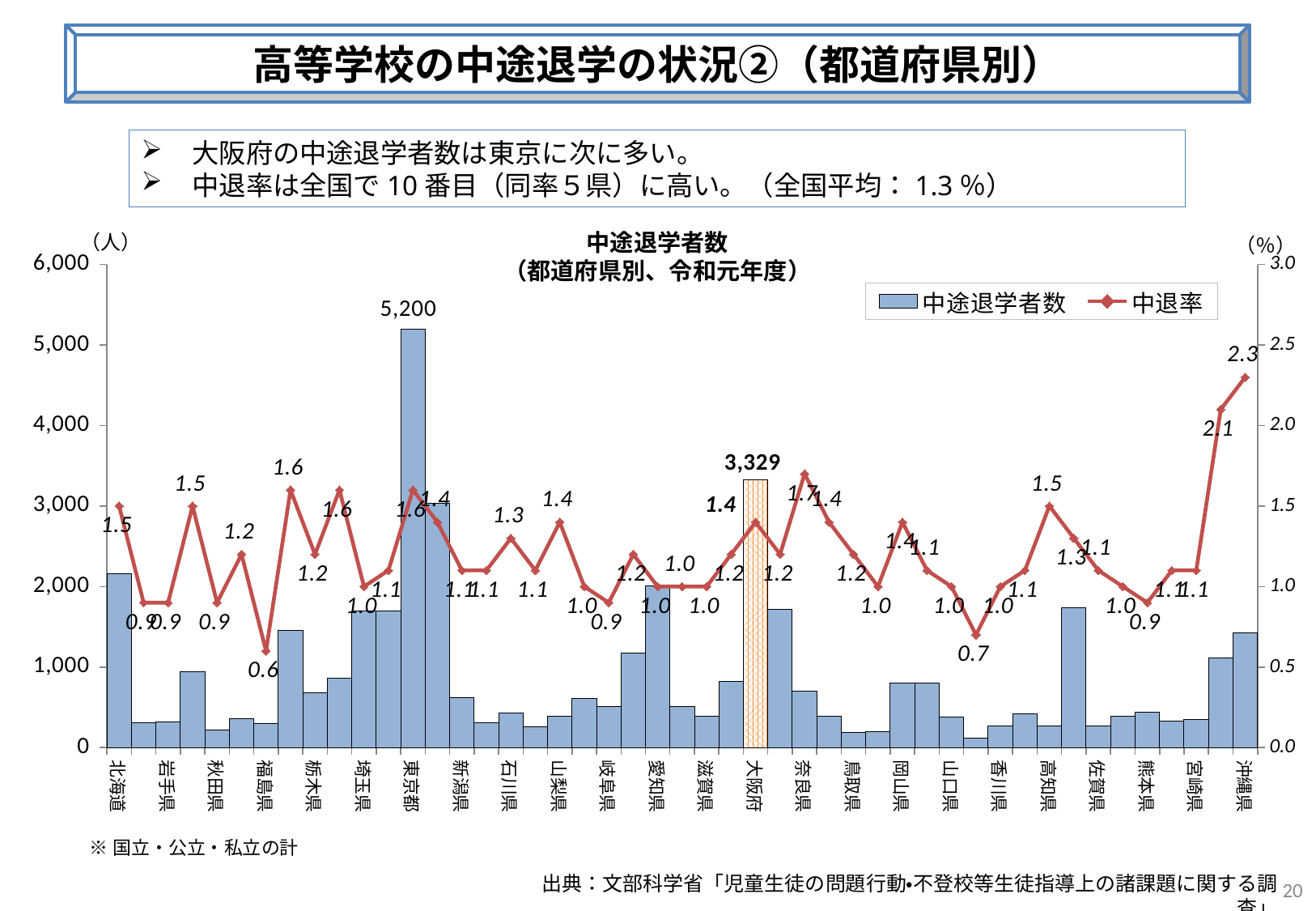
Which prefecture has the lowest 中退率, and what is its value? 福島県, 0.6 What is the difference in 中途退学者数 between 東京都 and 大阪府? 1,871 What is the 中退率 for 北海道? 1.5 How many series does the legend list? 2 What is the number of 中途退学者数 for 大阪府? 3,329 Is the 中途退学者数 bar for 岩手県 greater or less than 1,000? less What is the 中退率 for 沖縄県? 2.3 What is the number of 中途退学者数 for 東京都? 5,200 Which prefecture has the highest 中退率? 沖縄県 Which has the larger 中途退学者数 bar, 大阪府 or 愛知県? 大阪府 Which prefecture has the highest 中途退学者数 bar? 東京都 What kind of chart is shown on the slide? A combined bar and line chart